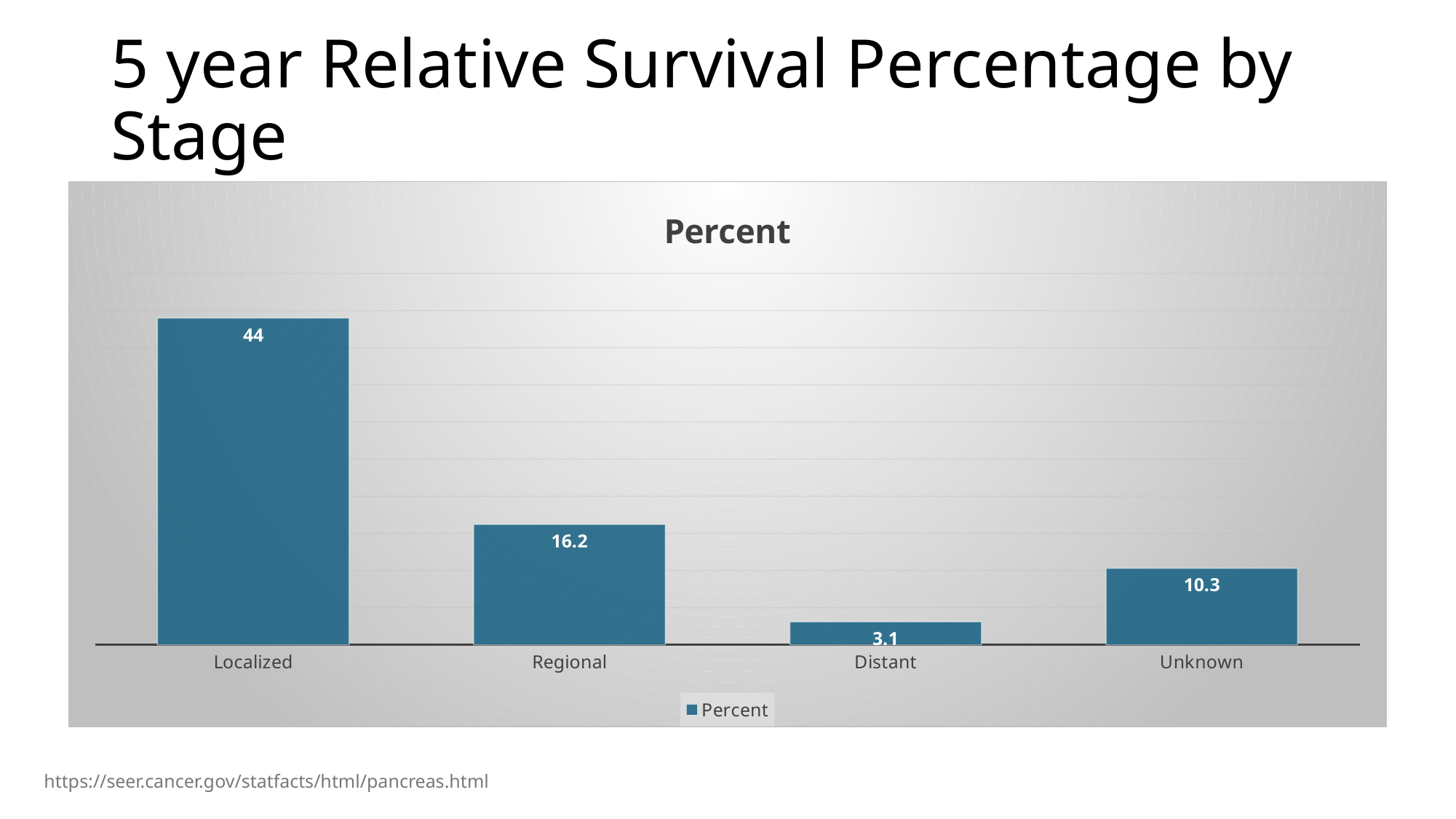
What is the value for Unknown? 10.3 What kind of chart is shown? Bar chart What is the difference between the values for Localized and Regional? 27.8 What is the value for Localized? 44 Which stage has the lowest value? Distant What is the value for Regional? 16.2 How many stages are shown on the x axis? 4 How many series does the legend list? 1 Which is larger, the value for Regional or the value for Unknown? Regional What is the value for Distant? 3.1 Which stage has the highest value? Localized What is the difference between the values for Unknown and Distant? 7.2